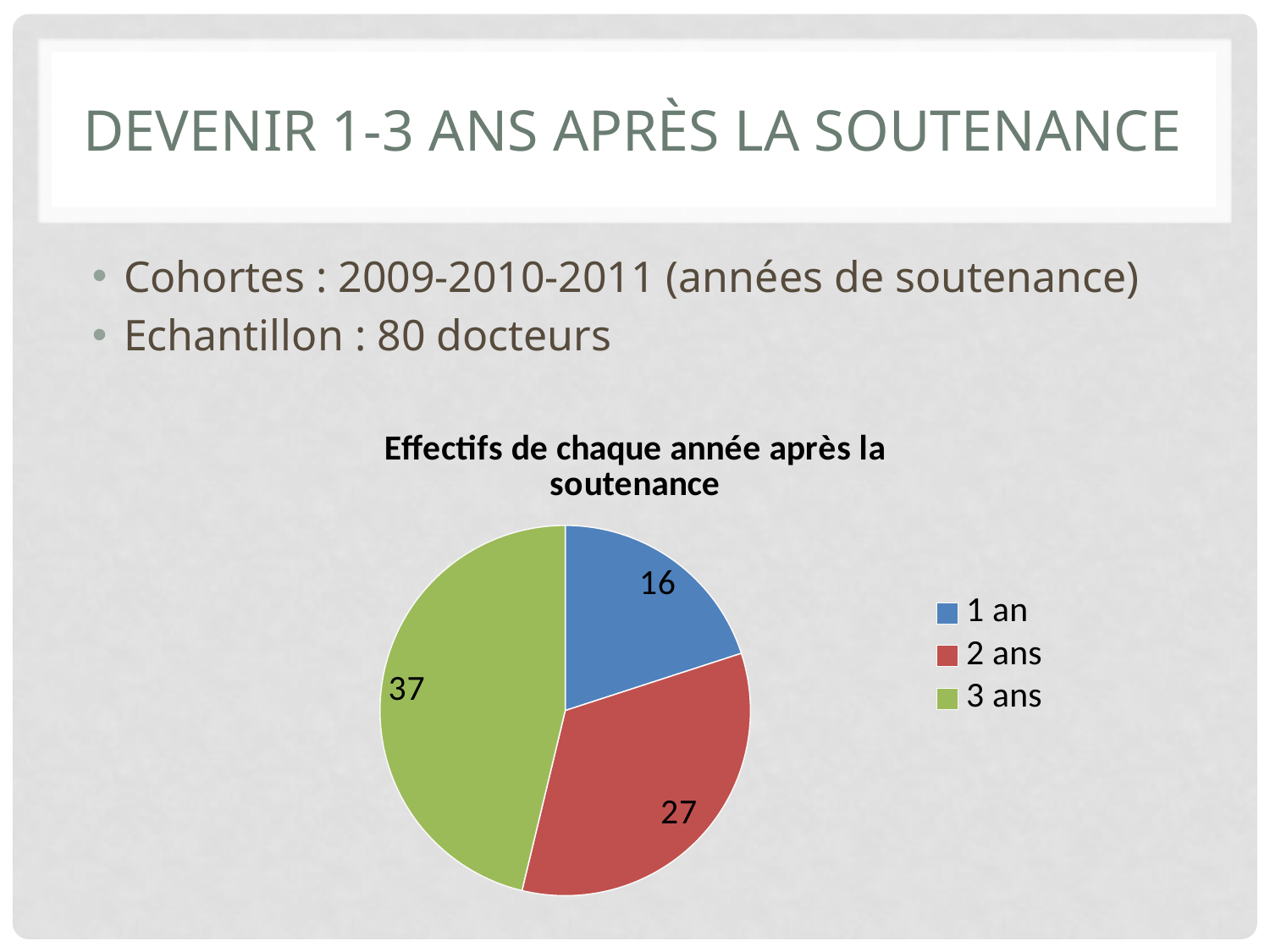
What is the total of all the slices in the pie chart? 80 What is the value for the "2 ans" slice? 27 Which category has the smallest slice? 1 an What is the difference between the values for "2 ans" and "1 an"? 11 What is the title of the chart? Effectifs de chaque année après la soutenance Which category has the largest slice? 3 ans What is the difference between the values for "3 ans" and "1 an"? 21 What kind of chart is shown on the slide? pie chart What is the value for the "1 an" slice? 16 What is the value for the "3 ans" slice? 37 Which is larger, the value for "2 ans" or the value for "3 ans"? 3 ans How many slices does the pie chart have? 3